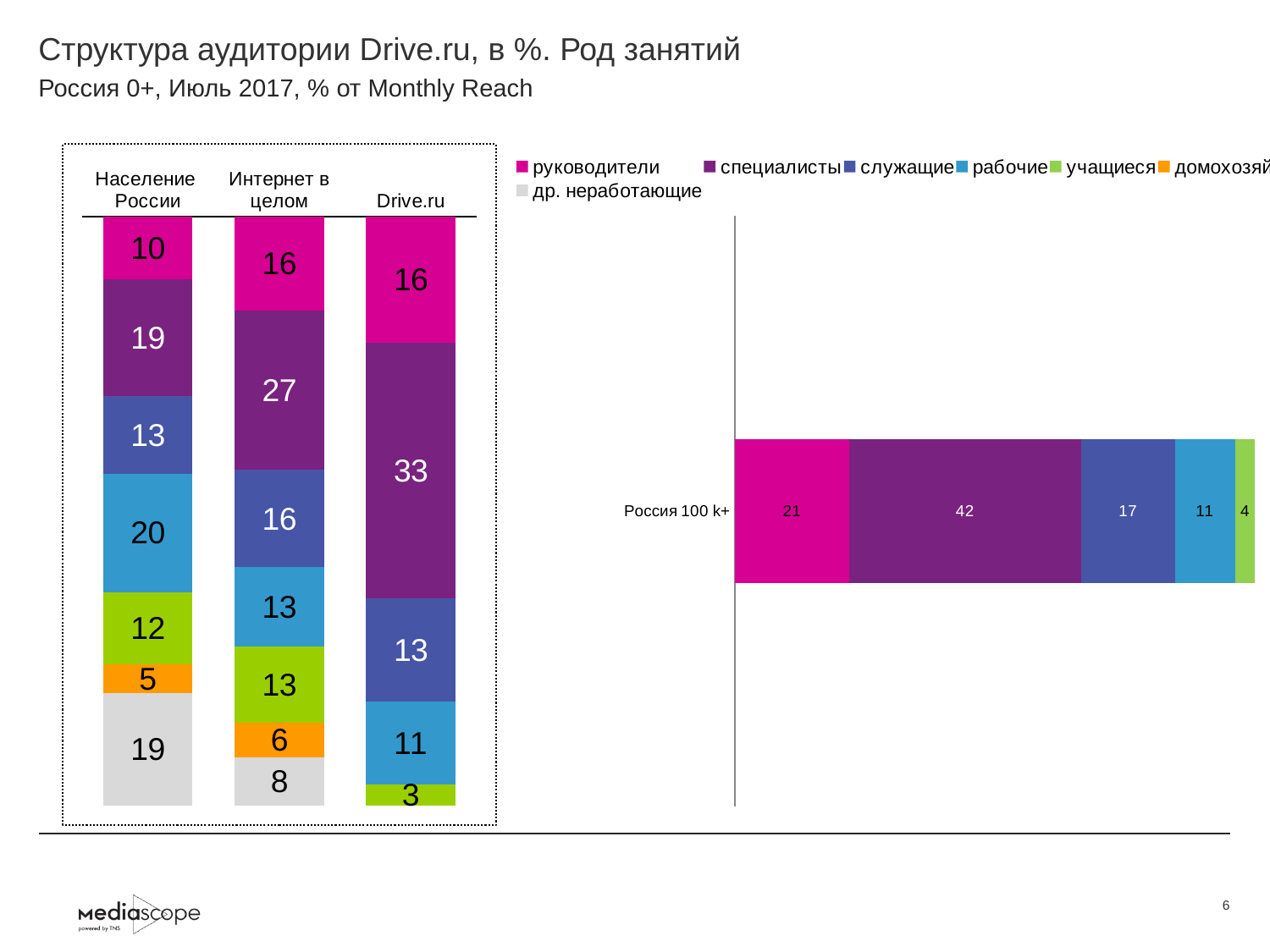
In the left stacked bar chart, what is the difference between the специалисты values for Drive.ru and Население России? 14 How many series does the legend list? 7 In the left stacked bar chart, which segment is the largest in the Drive.ru bar? специалисты In the left stacked bar chart, what is the value for др. неработающие in the Интернет в целом bar? 8 In the left stacked bar chart, which segment is the smallest in the Drive.ru bar? учащиеся In the right chart, what is the value for специалисты in the Россия 100 k+ bar? 42 In the left stacked bar chart, what is the value for рабочие in the Население России bar? 20 In the left stacked bar chart, what is the value for специалисты in the Drive.ru bar? 33 What type of chart is the right chart showing Россия 100 k+? Stacked bar chart In the right chart, what is the value for руководители in the Россия 100 k+ bar? 21 How many bars (categories) does the left stacked bar chart show? 3 In the left stacked bar chart, which is larger: the руководители value for Интернет в целом or for Население России? Интернет в целом